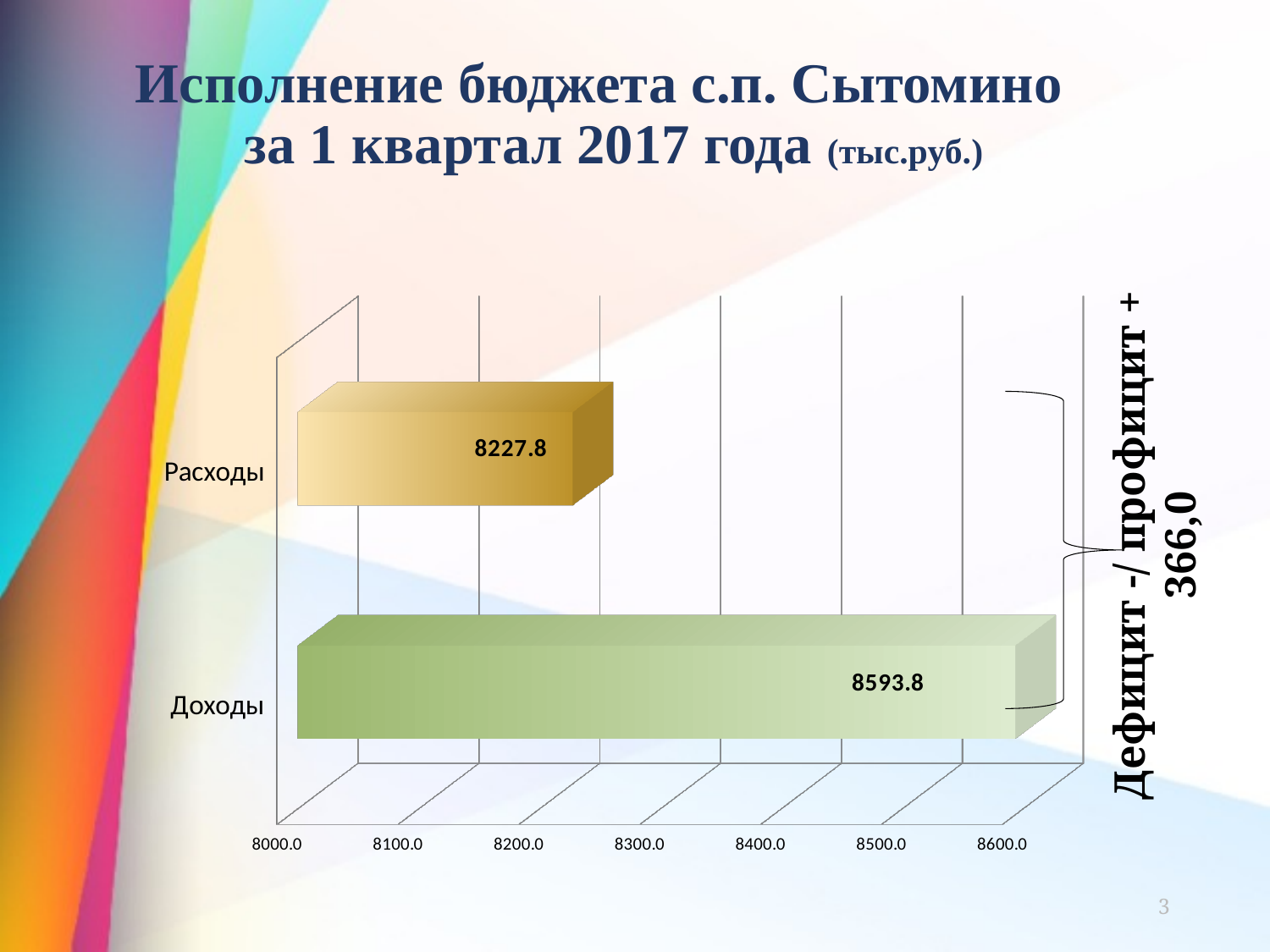
What is the difference between Доходы and Расходы? 366.0 What is the value for Расходы? 8227.8 What kind of chart is shown on the slide? bar chart Which category has the highest value? Доходы Which is larger, Расходы or Доходы? Доходы How many categories are shown in the chart? 2 Is the value for Доходы greater or less than 8500.0? greater What is the title of the slide? Исполнение бюджета с.п. Сытомино за 1 квартал 2017 года (тыс.руб.) Which category has the lowest value? Расходы What is the value for Доходы? 8593.8 Is the value for Расходы greater or less than 8300.0? less What value is given for the deficit/surplus (Дефицит -/ профицит +) on the slide? 366,0